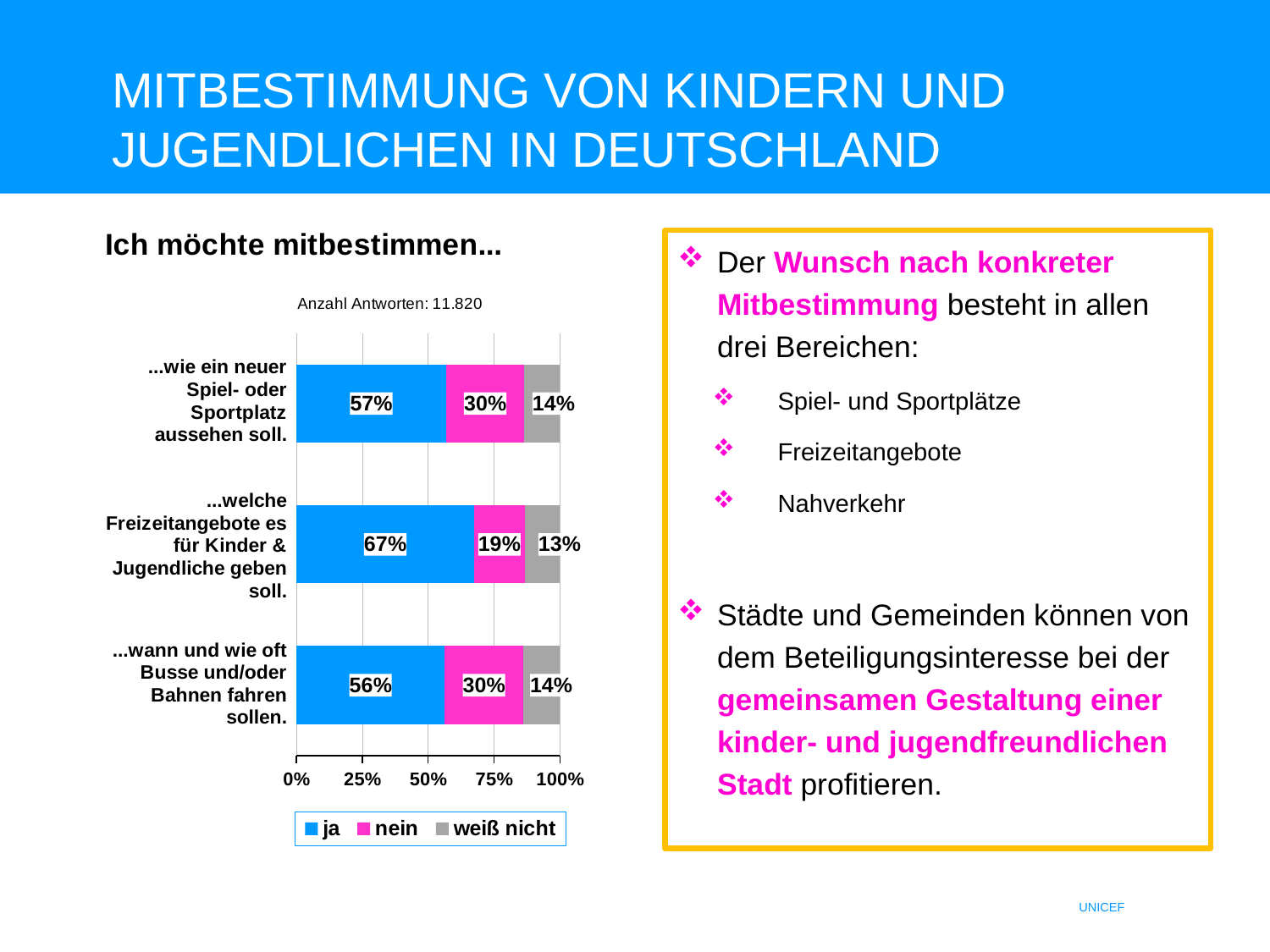
How many series does the legend list? 3 What type of chart is shown on the slide? Stacked bar chart How many responses (Anzahl Antworten) does the chart subtitle report? 11.820 Which category has the lowest "nein" share? ...welche Freizeitangebote es für Kinder & Jugendliche geben soll. Is the "ja" value for the Freizeitangebote category greater or less than 50%? greater What is the "weiß nicht" value for the category about how a new Spiel- oder Sportplatz should look? 14% What share answered "nein" for the category about when and how often buses and trains should run? 30% How many categories (bars) does the chart show? 3 Which category has the highest "ja" share? ...welche Freizeitangebote es für Kinder & Jugendliche geben soll. What percentage of respondents answered "ja" to wanting a say in which Freizeitangebote there should be for children and young people? 67% Is the "ja" share larger for the Spiel- oder Sportplatz category or for the Busse und/oder Bahnen category? Spiel- oder Sportplatz What is the difference between the "ja" share for Freizeitangebote and the "ja" share for Busse und/oder Bahnen? 11 percentage points